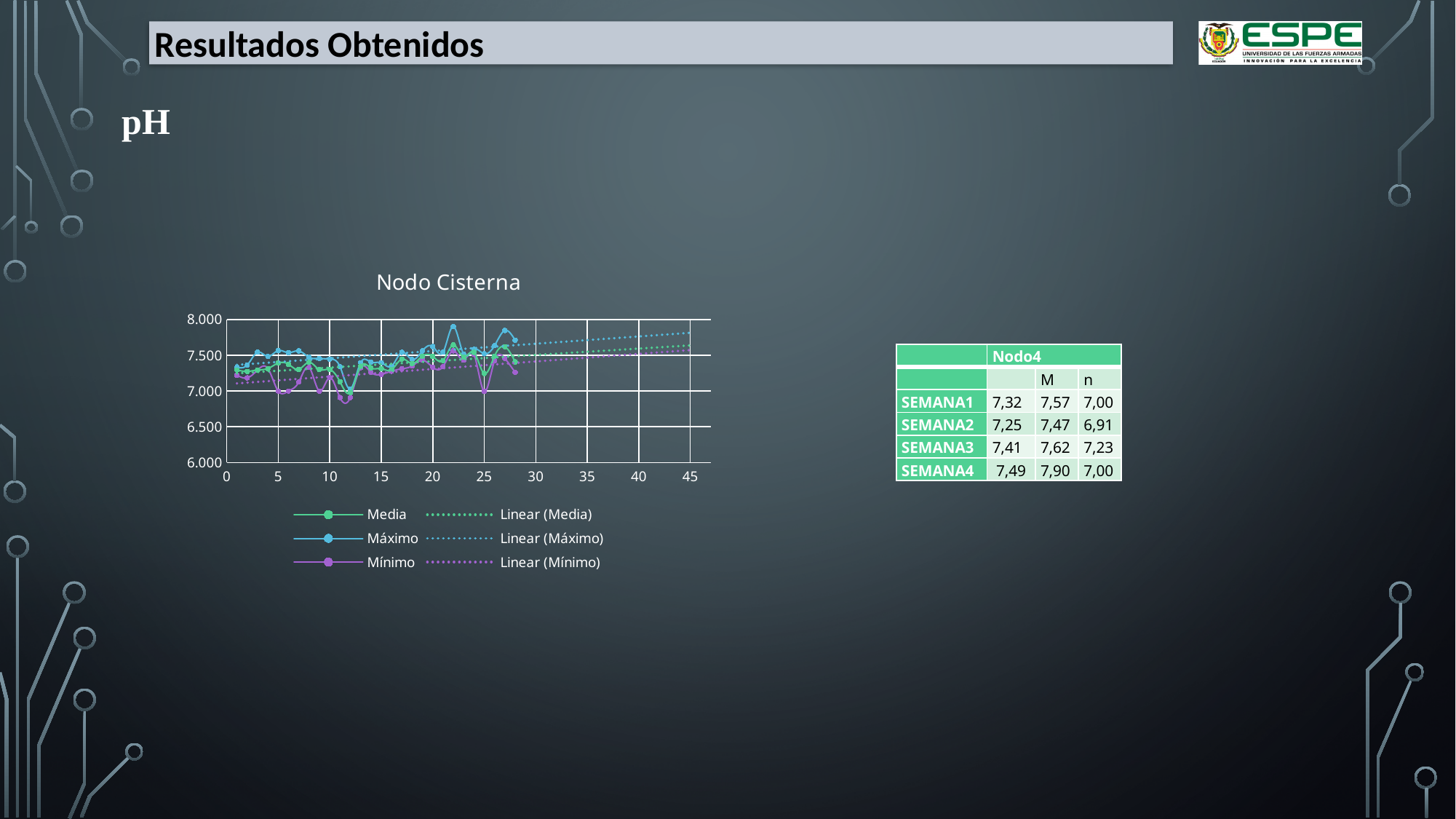
In the "Nodo Cisterna" chart, is the Media value at x = 1 greater or less than 7.000? greater In the "Nodo Cisterna" chart, which series is plotted in purple? Mínimo In the "Nodo Cisterna" chart, is the Mínimo value at x = 12 greater or less than 7.000? less In the "Nodo Cisterna" chart, is the Máximo value at x = 22 greater or less than 7.500? greater In the "Nodo Cisterna" chart, which of the three plotted series generally has the lowest values? Mínimo What kind of chart is the "Nodo Cisterna" chart? line chart In the "Nodo Cisterna" chart, which series is larger at x = 22, Máximo or Mínimo? Máximo In the "Nodo Cisterna" chart, which of the three plotted series generally has the highest values? Máximo What is the title of the chart on the slide? Nodo Cisterna In the "Nodo Cisterna" chart, do the dotted linear trend lines rise or fall along the x axis? rise How many entries does the legend of the "Nodo Cisterna" chart list? 6